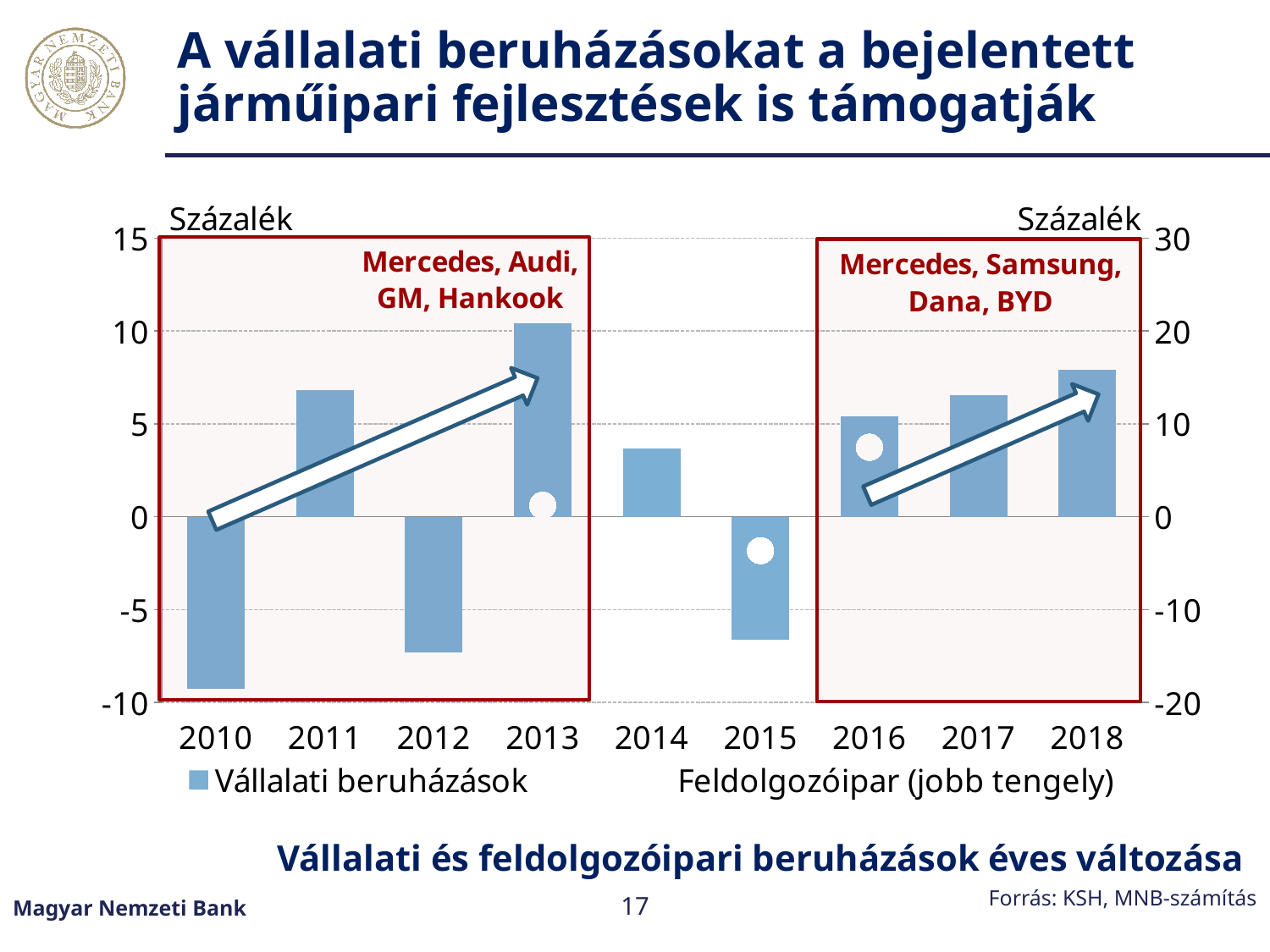
How many series does the chart legend list? 2 What is the title of the chart shown below the plot area? Vállalati és feldolgozóipari beruházások éves változása Is the Vállalati beruházások value for 2018 greater or less than 5? greater Is the Vállalati beruházások value for 2010 greater or less than -5? less What kind of chart is shown on the slide? combination bar and line chart Do the Vállalati beruházások bars rise or fall from 2016 to 2018? rise Which year has the highest bar for Vállalati beruházások? 2013 Which companies are named in the annotation box over the 2016–2018 bars? Mercedes, Samsung, Dana, BYD How many years are shown on the x axis of the chart? 9 Which year has the lowest bar for Vállalati beruházások? 2010 Is the Vállalati beruházások value for 2014 greater or less than 5? less Is the Vállalati beruházások bar for 2013 higher or lower than the bar for 2011? higher